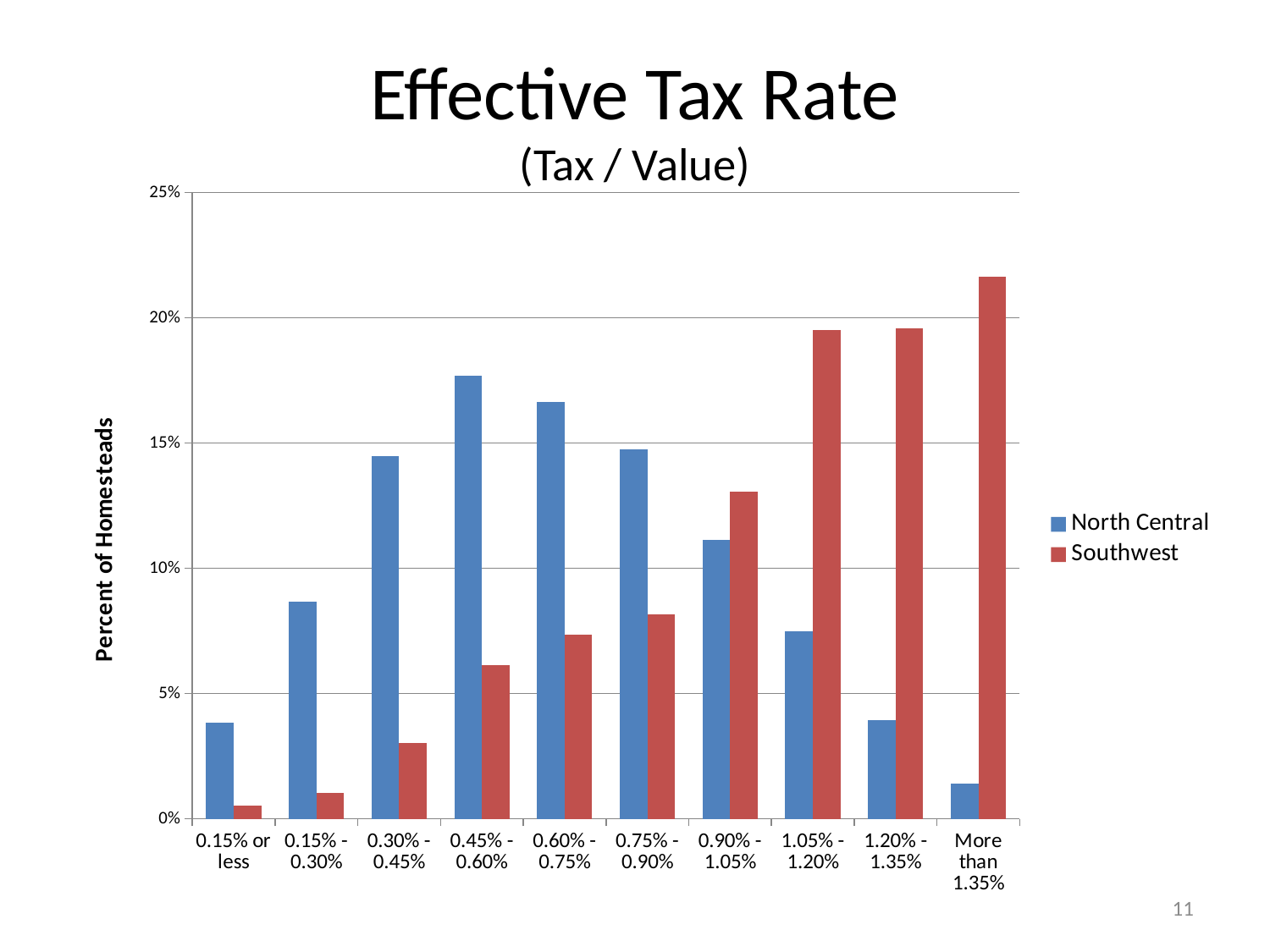
What kind of chart is shown on the slide? bar chart Is the Southwest value for More than 1.35% greater or less than 20%? greater How many series does the legend list? 2 For which category is the North Central value highest? 0.45% - 0.60% For which category is the North Central value lowest? More than 1.35% Is the North Central value for 1.05% - 1.20% greater or less than 5%? greater Is the Southwest value for 0.30% - 0.45% greater or less than 5%? less What is the title of the vertical axis? Percent of Homesteads In the 1.20% - 1.35% category, which series has the larger value, North Central or Southwest? Southwest For which category is the Southwest value lowest? 0.15% or less How many effective tax rate categories are shown on the x axis? 10 For which category is the Southwest value highest? More than 1.35%